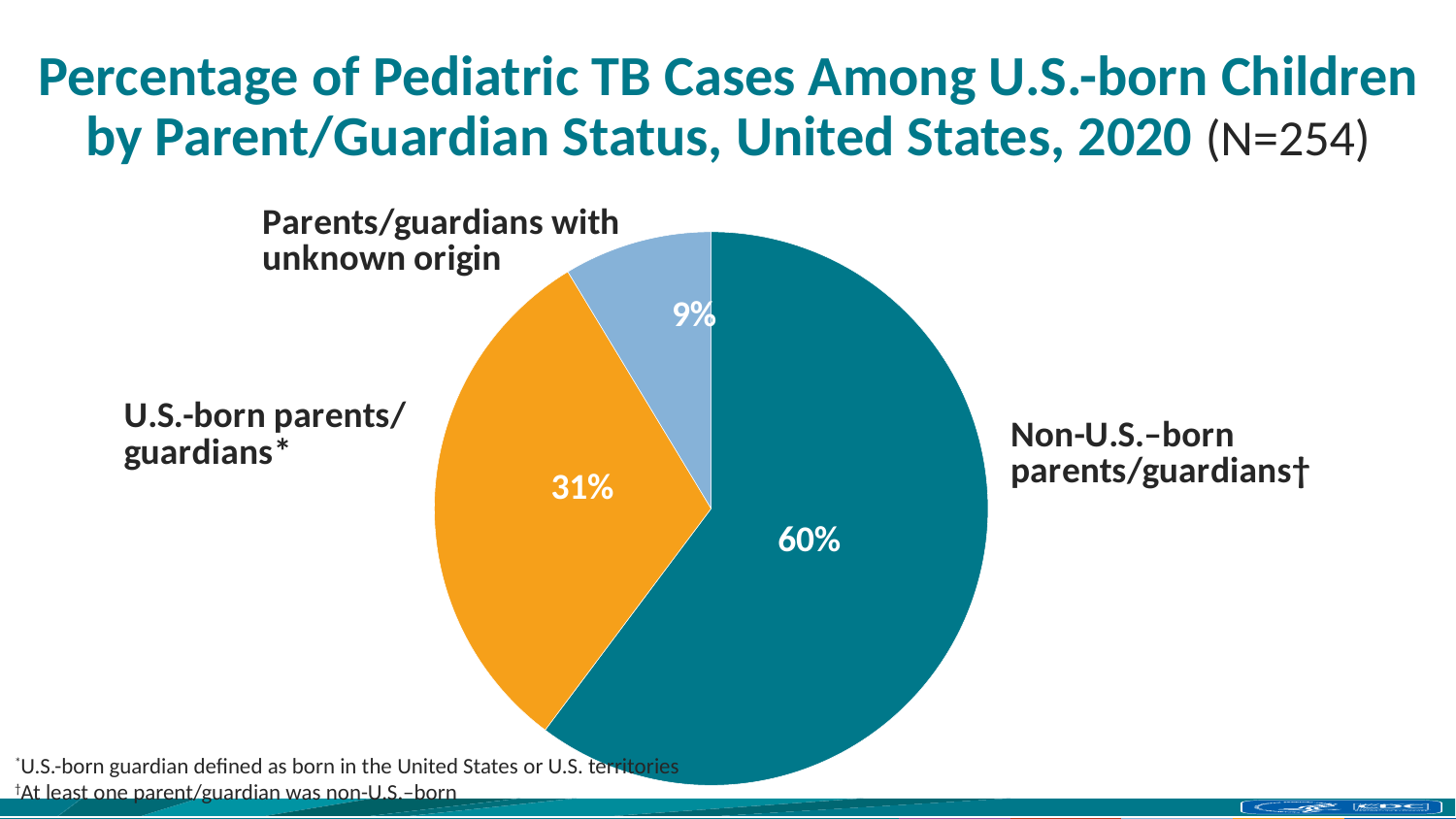
Which is larger: the share for U.S.-born parents/guardians or the share for parents/guardians with unknown origin? U.S.-born parents/guardians What is the total number of cases (N) stated in the chart title? 254 What colour is the slice representing non-U.S.-born parents/guardians? Teal What kind of chart is shown on the slide? Pie chart Which parent/guardian status category accounts for the largest share of cases? Non-U.S.-born parents/guardians Which parent/guardian status category accounts for the smallest share of cases? Parents/guardians with unknown origin What is the difference in percentage points between the U.S.-born parents/guardians slice and the unknown origin slice? 22 percentage points What percentage of cases had parents/guardians with unknown origin? 9% What percentage of pediatric TB cases among U.S.-born children had non-U.S.-born parents/guardians? 60% How many categories are shown in the pie chart? 3 What percentage of cases had U.S.-born parents/guardians? 31% What is the difference in percentage points between the non-U.S.-born parents/guardians slice and the U.S.-born parents/guardians slice? 29 percentage points